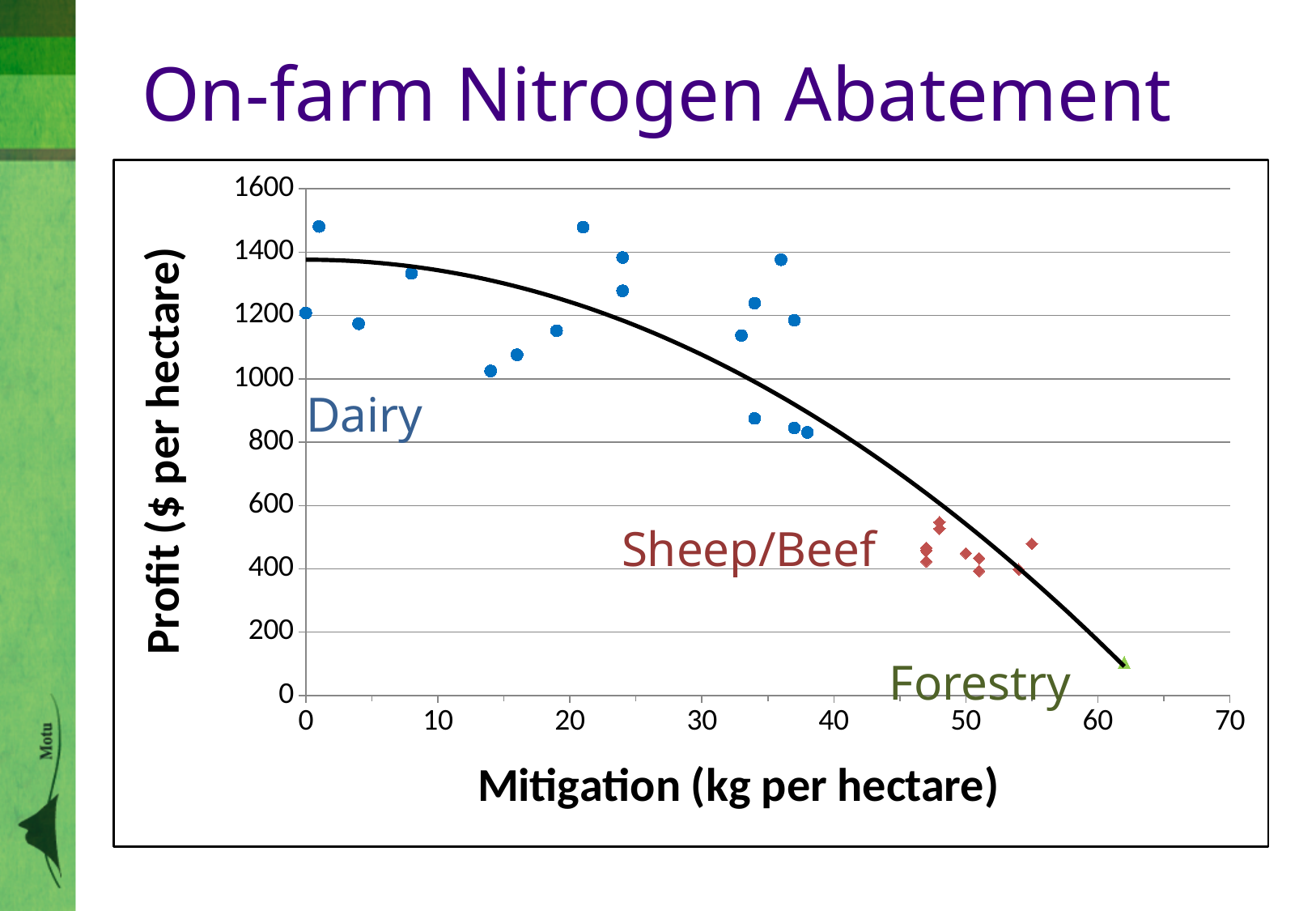
Which group has higher profit per hectare, Dairy or Sheep/Beef? Dairy What kind of chart is shown on the slide? scatter chart Which labelled group has the lowest profit per hectare? Forestry How many farm-type groups are labelled on the chart? 3 Does profit rise or fall as mitigation increases along the x axis? fall Which labelled group has the highest mitigation (kg per hectare)? Forestry Which labelled group has the highest profit per hectare? Dairy Is the profit value for Forestry greater or less than 200? less What is the title of the slide's chart? On-farm Nitrogen Abatement Are the Dairy profit values greater or less than 600? greater Are the Sheep/Beef profit values greater or less than 600? less What is the label of the x axis? Mitigation (kg per hectare)